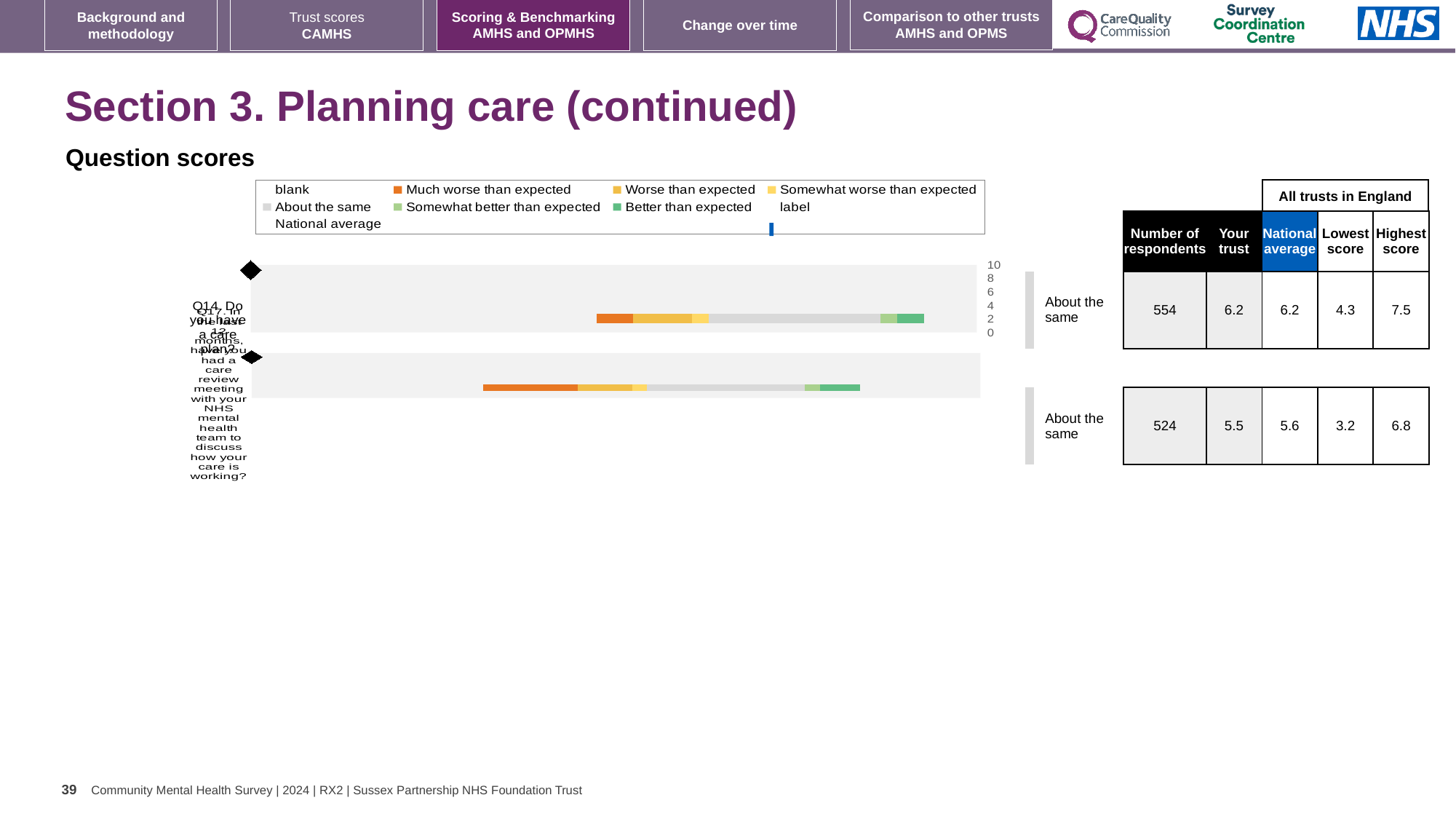
What is the national average score for Q17 (care review meeting)? 5.6 Which colour in the legend represents 'Much worse than expected'? orange What kind of chart is shown on the slide? bar chart What benchmark category is shown next to the bar for Q17 (care review meeting)? About the same Which question has more respondents, Q14 or Q17? Q14 What is the highest score among all trusts in England for Q14 (Do you have a care plan?)? 7.5 How many respondents are listed for Q14 (Do you have a care plan?)? 554 What is the 'Your trust' score for Q14 (Do you have a care plan?)? 6.2 How many questions (bars) are plotted in the chart? 2 What is the lowest score among all trusts in England for Q17 (care review meeting)? 3.2 Which colour in the legend represents 'Better than expected'? green What is the difference between the highest score and the lowest score for Q17 (care review meeting)? 3.6